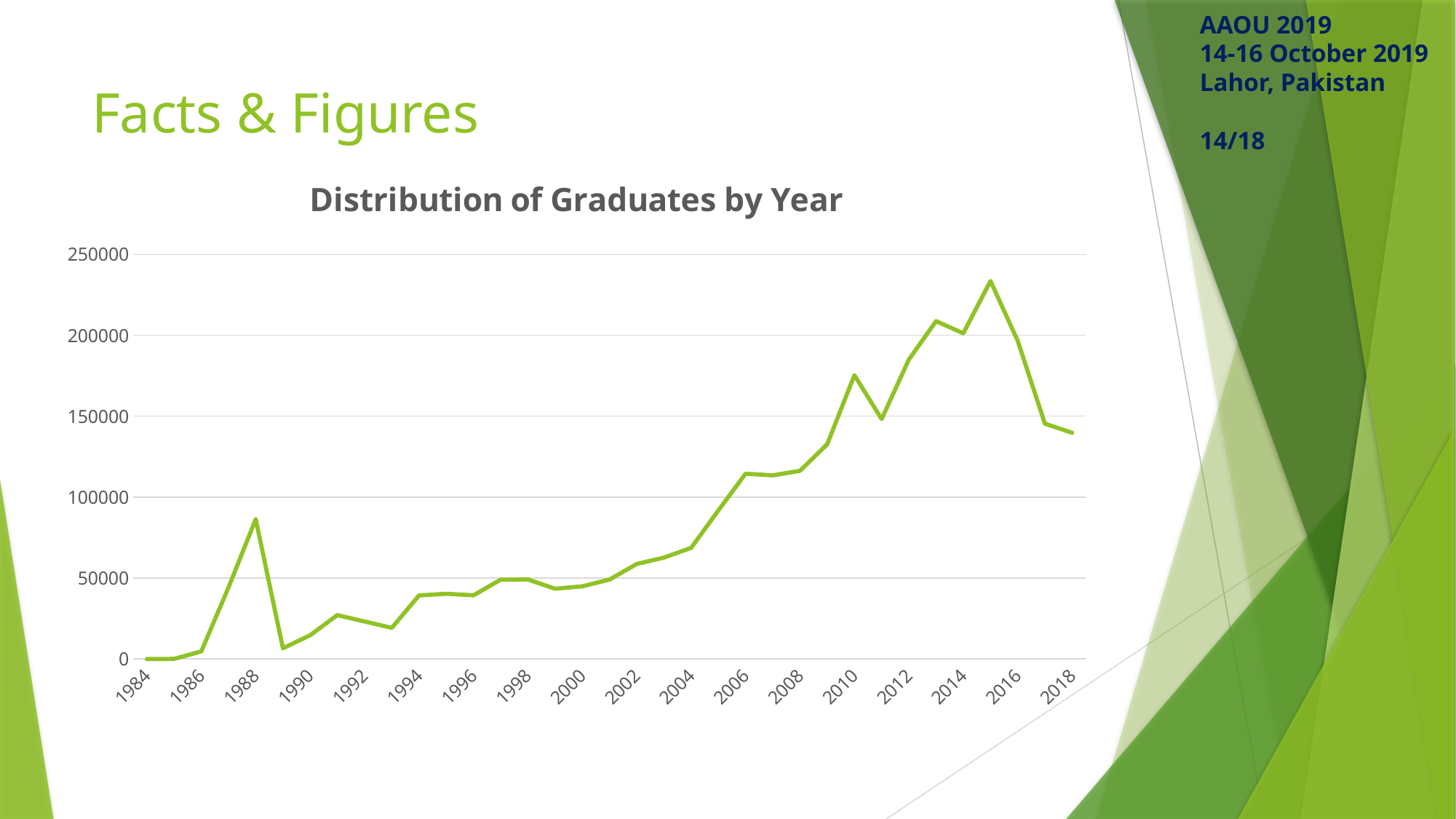
Which is larger, the value for 2016 or the value for 2018? 2016 What kind of chart is shown on the slide? line chart Which year has the highest number of graduates? 2015 Which is larger, the value for 1988 or the value for 1990? 1988 Is the value for 2006 greater or less than 100000? greater Is the value for 2012 greater or less than 200000? less Is the value for 2010 greater or less than 150000? greater What is the title of the chart? Distribution of Graduates by Year Do the values rise or fall from 2015 to 2018? fall